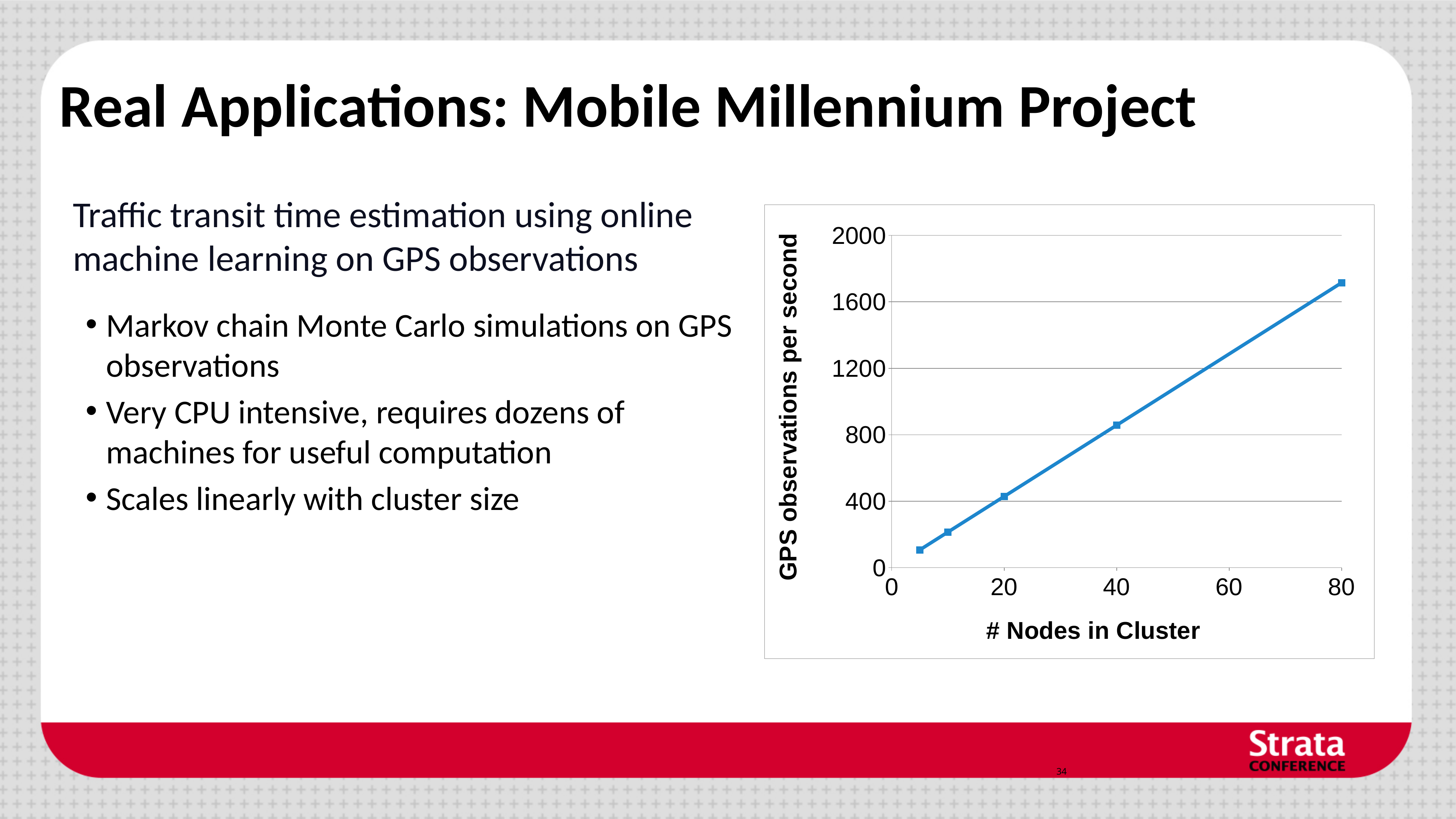
Is the value for 20 nodes greater or less than 800 GPS observations per second? less How many data points are plotted on the line? 5 What kind of chart is shown on the slide? line chart Do GPS observations per second rise or fall as the number of nodes in the cluster increases? rise At which number of nodes in the cluster is GPS observations per second highest? 80 What is the title of the y axis of the chart? GPS observations per second Is the value for 80 nodes greater or less than 1600 GPS observations per second? greater What is the title of the x axis of the chart? # Nodes in Cluster What is the highest value shown on the y axis of the chart? 2000 Is the value for 40 nodes greater or less than 400 GPS observations per second? greater Which has more GPS observations per second, 40 nodes or 80 nodes? 80 nodes